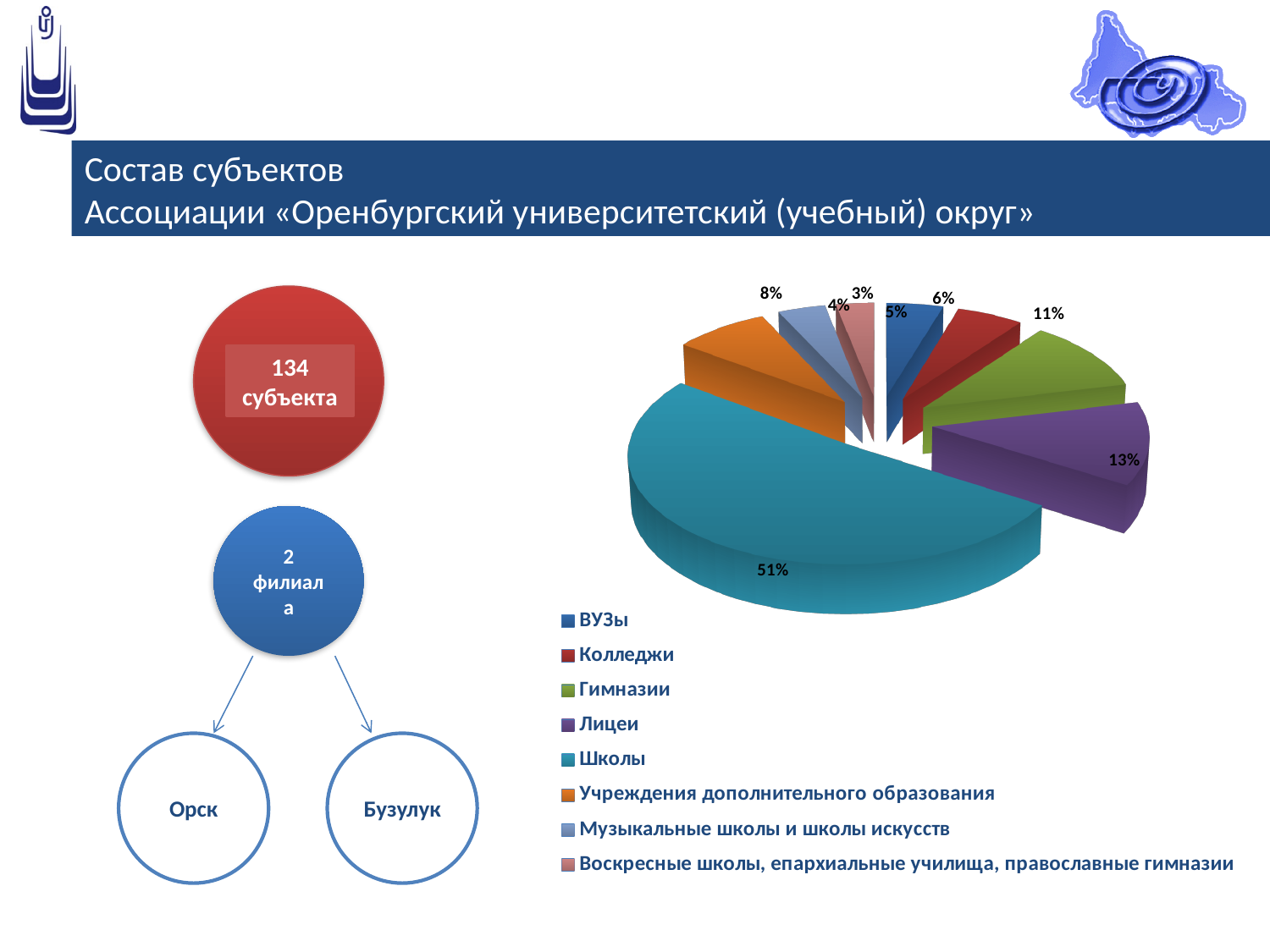
Which has a larger share in the pie chart, Гимназии or Музыкальные школы и школы искусств? Гимназии What type of chart is shown on the slide? Pie chart How many categories does the pie chart legend list? 8 What colour is the slice for Школы in the pie chart? Teal Which category has the smallest slice in the pie chart? Воскресные школы, епархиальные училища, православные гимназии Which category has the largest slice in the pie chart? Школы What percentage is shown for Гимназии in the pie chart? 11% What percentage is shown for Лицеи in the pie chart? 13% What percentage is shown for Учреждения дополнительного образования in the pie chart? 8% What is the difference in percentage points between Лицеи and Колледжи in the pie chart? 7 What share of the pie chart does Школы account for? 51% What percentage is shown for ВУЗы in the pie chart? 5%